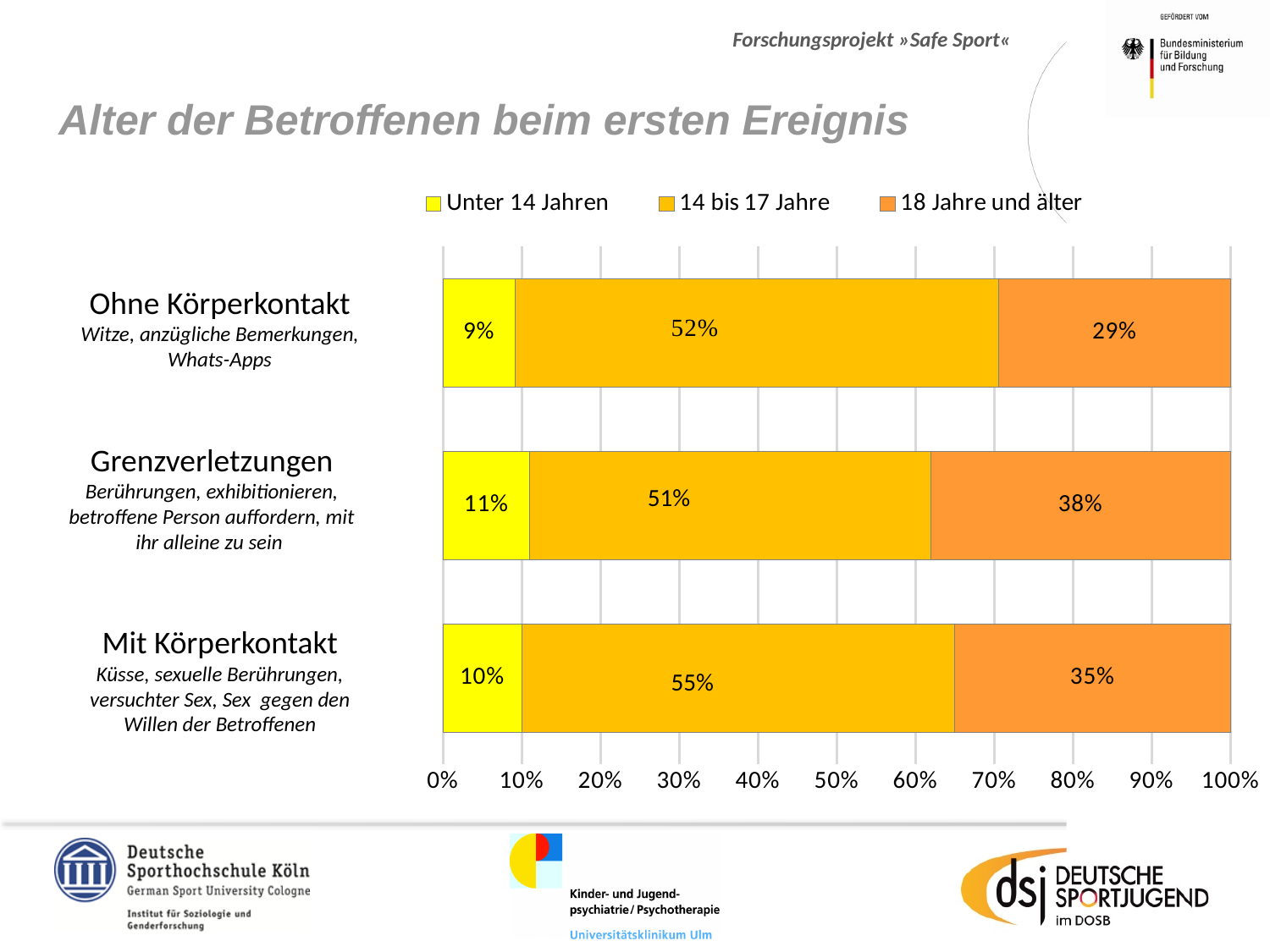
What is the value for 'Unter 14 Jahren' in the 'Ohne Körperkontakt' category? 9% How many categories are plotted on the chart? 3 Which is larger: the '14 bis 17 Jahre' value for 'Mit Körperkontakt' or for 'Grenzverletzungen'? Mit Körperkontakt What is the value for '18 Jahre und älter' in the 'Grenzverletzungen' category? 38% What is the title of the slide containing the chart? Alter der Betroffenen beim ersten Ereignis Which category has the highest value for 'Unter 14 Jahren'? Grenzverletzungen Which category has the lowest value for '18 Jahre und älter'? Ohne Körperkontakt What is the value for '14 bis 17 Jahre' in the 'Mit Körperkontakt' category? 55% What is the difference between the '18 Jahre und älter' values for 'Grenzverletzungen' and 'Ohne Körperkontakt'? 9% How many series does the legend list? 3 What is the total of the stacked bar for 'Mit Körperkontakt'? 100% What kind of chart is shown on the slide? stacked bar chart